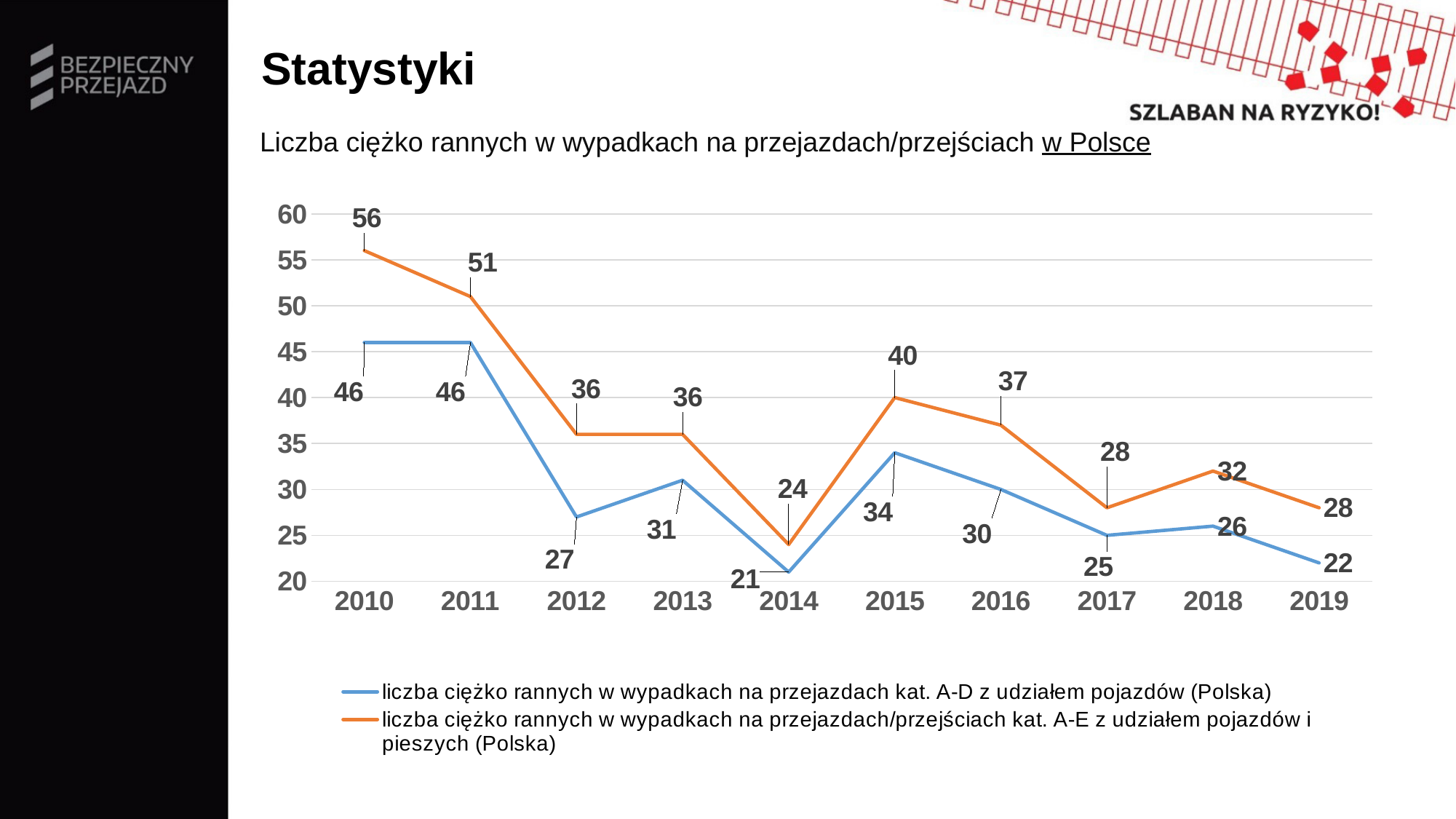
What is the value of the orange series (kat. A-E) in 2019? 28 What is the value of the orange series (kat. A-E z udziałem pojazdów i pieszych) in 2010? 56 Does the blue series (kat. A-D) generally rise or fall from 2010 to 2019? fall What is the title of the chart? Liczba ciężko rannych w wypadkach na przejazdach/przejściach w Polsce In which year is the blue series (kat. A-D) at its lowest? 2014 What type of chart is shown on the slide? line chart In which year is the orange series (kat. A-E) at its highest? 2010 Which series has the higher value in 2012, the blue (kat. A-D) or the orange (kat. A-E)? orange (kat. A-E) What is the difference between the orange series and the blue series in 2015? 6 What is the value of the blue series (kat. A-D z udziałem pojazdów) in 2014? 21 How many years are shown on the x axis? 10 How many series does the legend list? 2